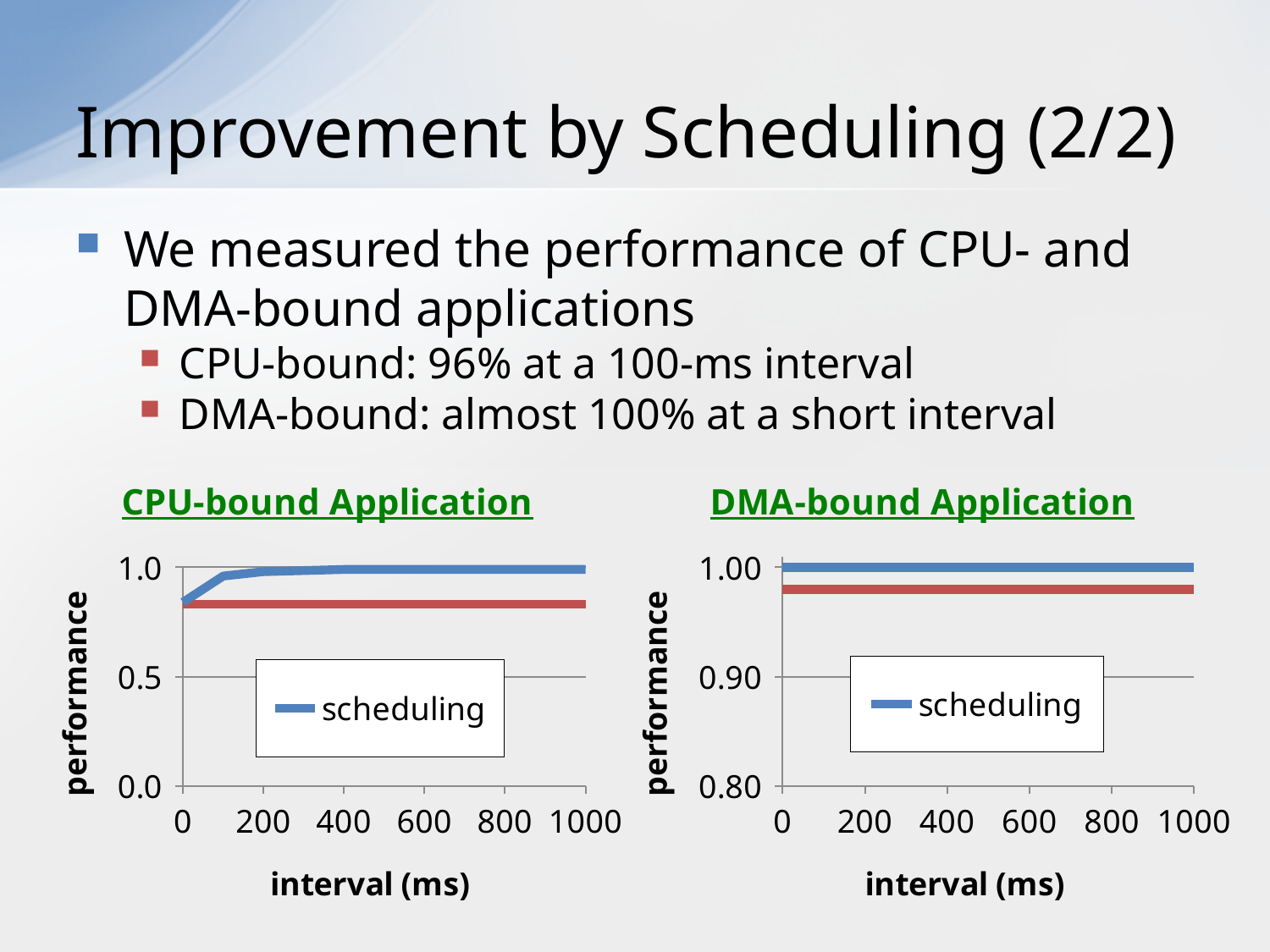
In the DMA-bound Application chart, is the value of the blue scheduling line greater or less than 0.90? greater What kind of chart is the DMA-bound Application chart? line chart What is the x-axis label of the DMA-bound Application chart? interval (ms) In the DMA-bound Application chart, is the value of the red line greater or less than 0.90? greater What kind of chart is the CPU-bound Application chart? line chart How many series does the legend of the CPU-bound Application chart list? 1 In the CPU-bound Application chart, is the value of the blue scheduling line at an interval of 1000 ms greater or less than 0.5? greater In the CPU-bound Application chart, does the blue scheduling line rise or fall as the interval increases from 0 to 200 ms? rise In the CPU-bound Application chart, at an interval of 1000 ms, which line has the higher performance, the blue scheduling line or the red line? the blue scheduling line In the DMA-bound Application chart, does the blue scheduling line rise, fall, or stay flat across the interval axis? stay flat In the DMA-bound Application chart, which line is higher, the blue scheduling line or the red line? the blue scheduling line